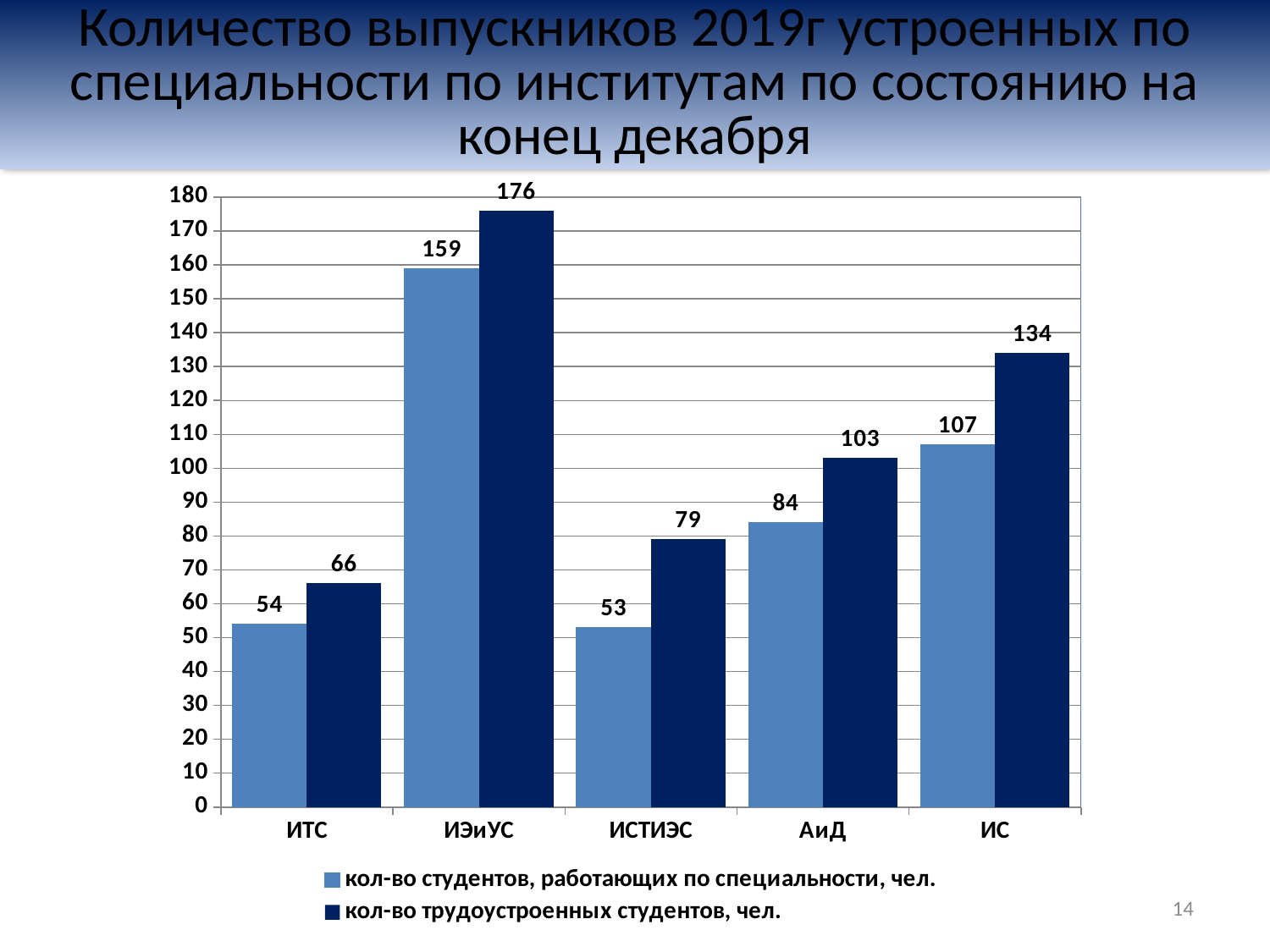
How many institutes are shown on the x axis? 5 Which institute has the lowest value in the series "кол-во трудоустроенных студентов, чел."? ИТС What is the difference between the two series values for ИС? 27 Which is larger: the "кол-во студентов, работающих по специальности, чел." value for ИТС or for ИС? ИС What kind of chart is shown on the slide? bar chart What is the difference between the "кол-во трудоустроенных студентов, чел." values for ИЭиУС and ИС? 42 What is the value for АиД in the series "кол-во студентов, работающих по специальности, чел."? 84 Which colour represents the series "кол-во трудоустроенных студентов, чел."? dark blue Which institute has the highest value in the series "кол-во студентов, работающих по специальности, чел."? ИЭиУС What is the value for ИСТИЭС in the series "кол-во трудоустроенных студентов, чел."? 79 What is the value for ИЭиУС in the series "кол-во трудоустроенных студентов, чел."? 176 How many series does the legend list? 2